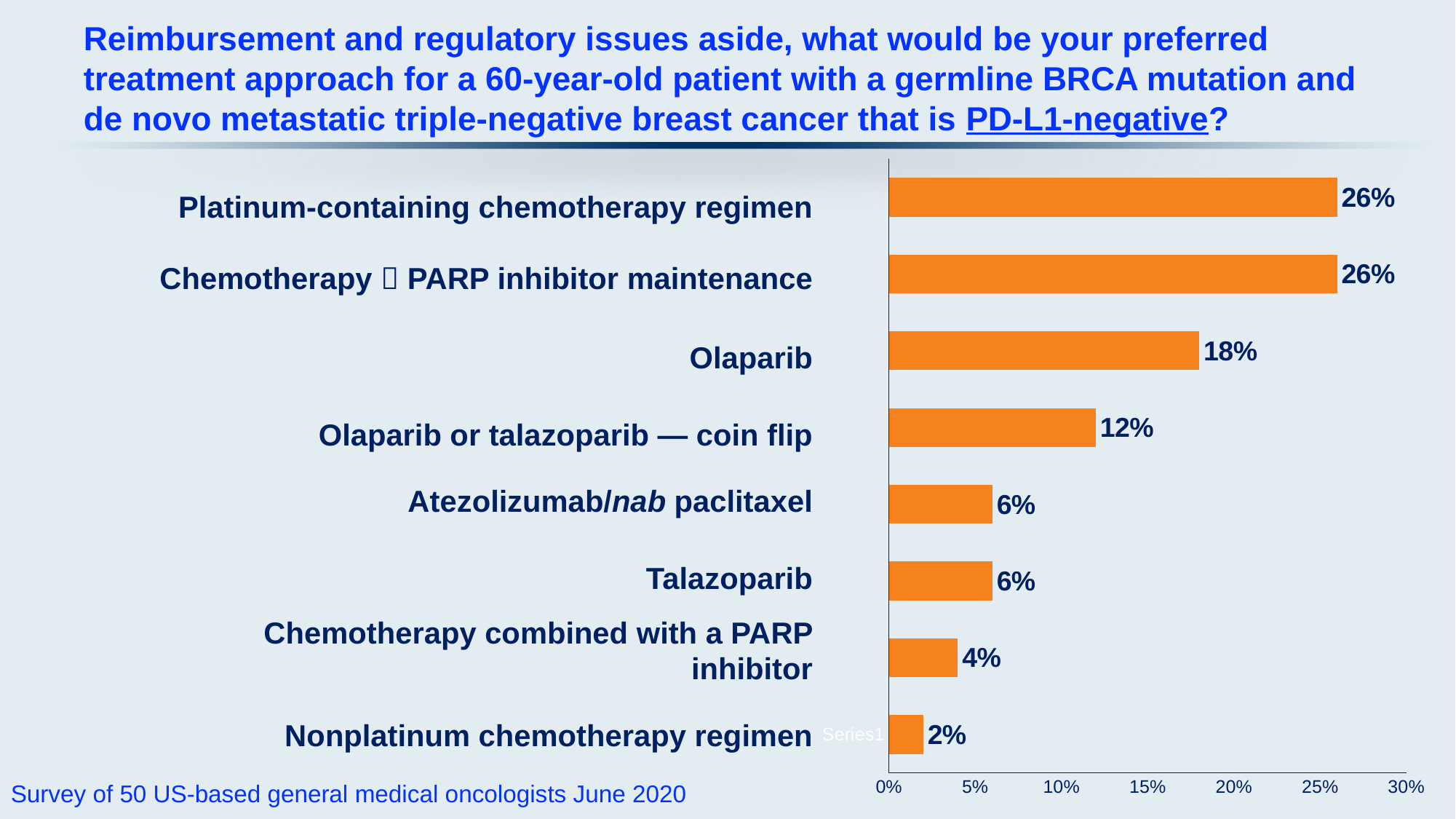
What colour are the bars in the chart? Orange How many treatment approaches are shown in the chart? 8 What percentage of respondents chose Olaparib as their preferred treatment approach? 18% What is the difference in percentage points between Olaparib and Talazoparib? 12 Which is larger: the value for Olaparib or the value for Atezolizumab/nab paclitaxel? Olaparib What is the value for 'Olaparib or talazoparib — coin flip'? 12% What is the maximum value shown on the x axis? 30% What is the difference between 'Platinum-containing chemotherapy regimen' and 'Olaparib or talazoparib — coin flip'? 14 Is the value for 'Chemotherapy → PARP inhibitor maintenance' greater or less than 25%? greater What percentage chose 'Chemotherapy combined with a PARP inhibitor'? 4% What kind of chart is shown on the slide? Bar chart Which treatment approach has the lowest percentage? Nonplatinum chemotherapy regimen